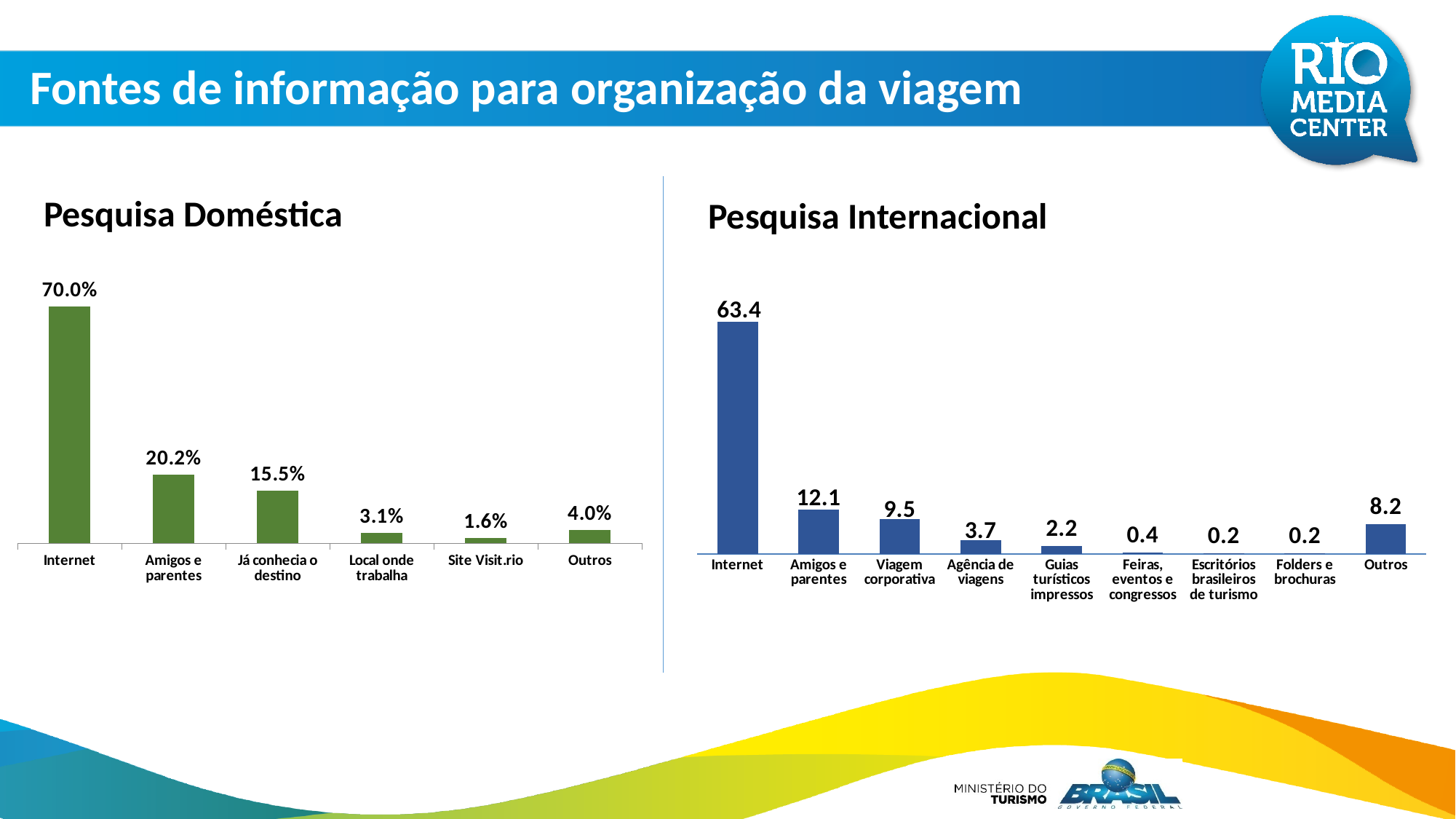
In the Pesquisa Internacional chart, how many categories are shown? 9 In the Pesquisa Doméstica chart, what is the value for Internet? 70.0% In the Pesquisa Internacional chart, what is the value for Guias turísticos impressos? 2.2 In the Pesquisa Internacional chart, what is the difference between Internet and Amigos e parentes? 51.3 In the Pesquisa Internacional chart, what is the value for Viagem corporativa? 9.5 In the Pesquisa Internacional chart, which is larger: Agência de viagens or Outros? Outros In the Pesquisa Doméstica chart, how many categories are shown? 6 In the Pesquisa Doméstica chart, what is the value for Já conhecia o destino? 15.5% What type of chart is the Pesquisa Internacional chart? Bar chart In the Pesquisa Doméstica chart, which category has the lowest value? Site Visit.rio In the Pesquisa Doméstica chart, what is the difference between Amigos e parentes and Outros? 16.2% In the Pesquisa Internacional chart, which category has the highest value? Internet